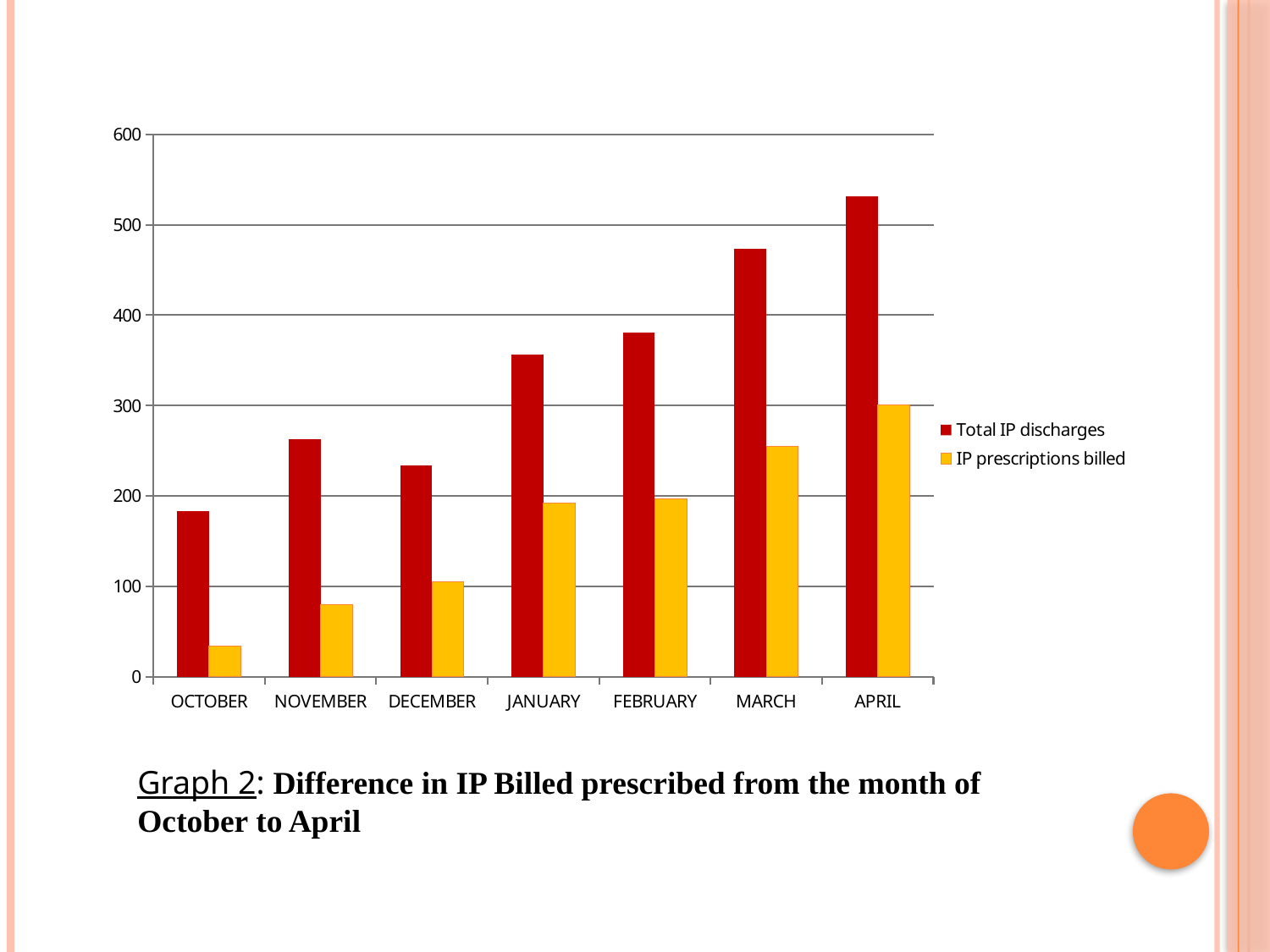
Which month has the lowest IP prescriptions billed? October Which month has the lowest Total IP discharges? October How many series does the legend list? 2 Which month has more Total IP discharges, November or December? November Which month has the highest IP prescriptions billed? April Do the IP prescriptions billed values rise or fall from October to April? Rise Is the value for Total IP discharges in April greater or less than 500? greater Which month has the highest Total IP discharges? April How many months are shown on the x axis? 7 Is the value for Total IP discharges in March greater or less than 400? greater What kind of chart is shown on the slide? Bar chart Is the value for IP prescriptions billed in October greater or less than 100? less